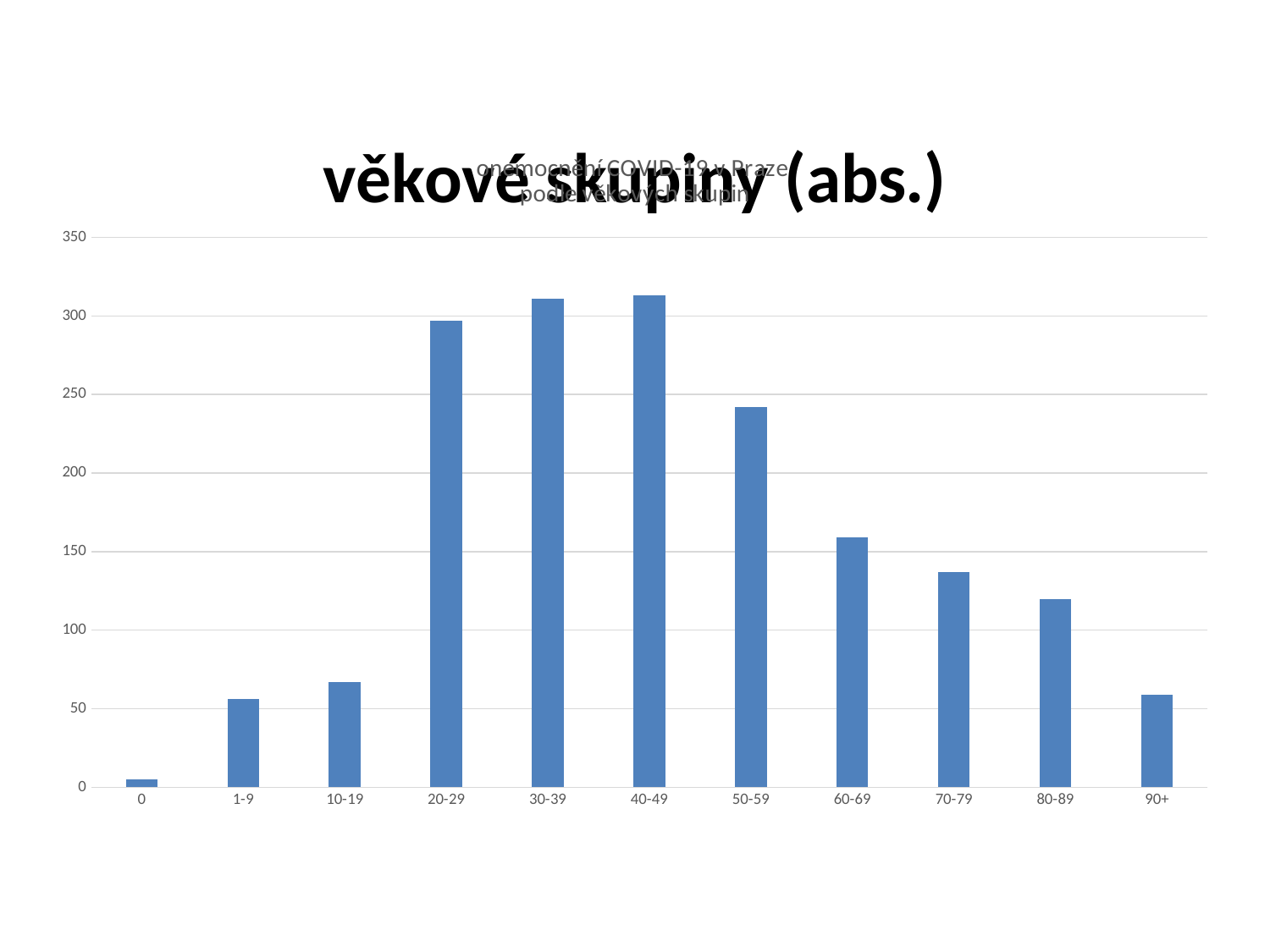
Is the value for the 50-59 age group greater or less than 250? less Is the value for the 80-89 age group greater or less than 100? greater Which age group has the lowest value? 0 Do the values rise or fall along the x axis from the 40-49 age group to the 90+ age group? fall Is the value for the 20-29 age group greater or less than 250? greater Which has a larger value, the 20-29 age group or the 50-59 age group? 20-29 How many age-group categories are shown on the x axis? 11 What is the large title printed above the chart? věkové skupiny (abs.) What kind of chart is shown on the slide? bar chart